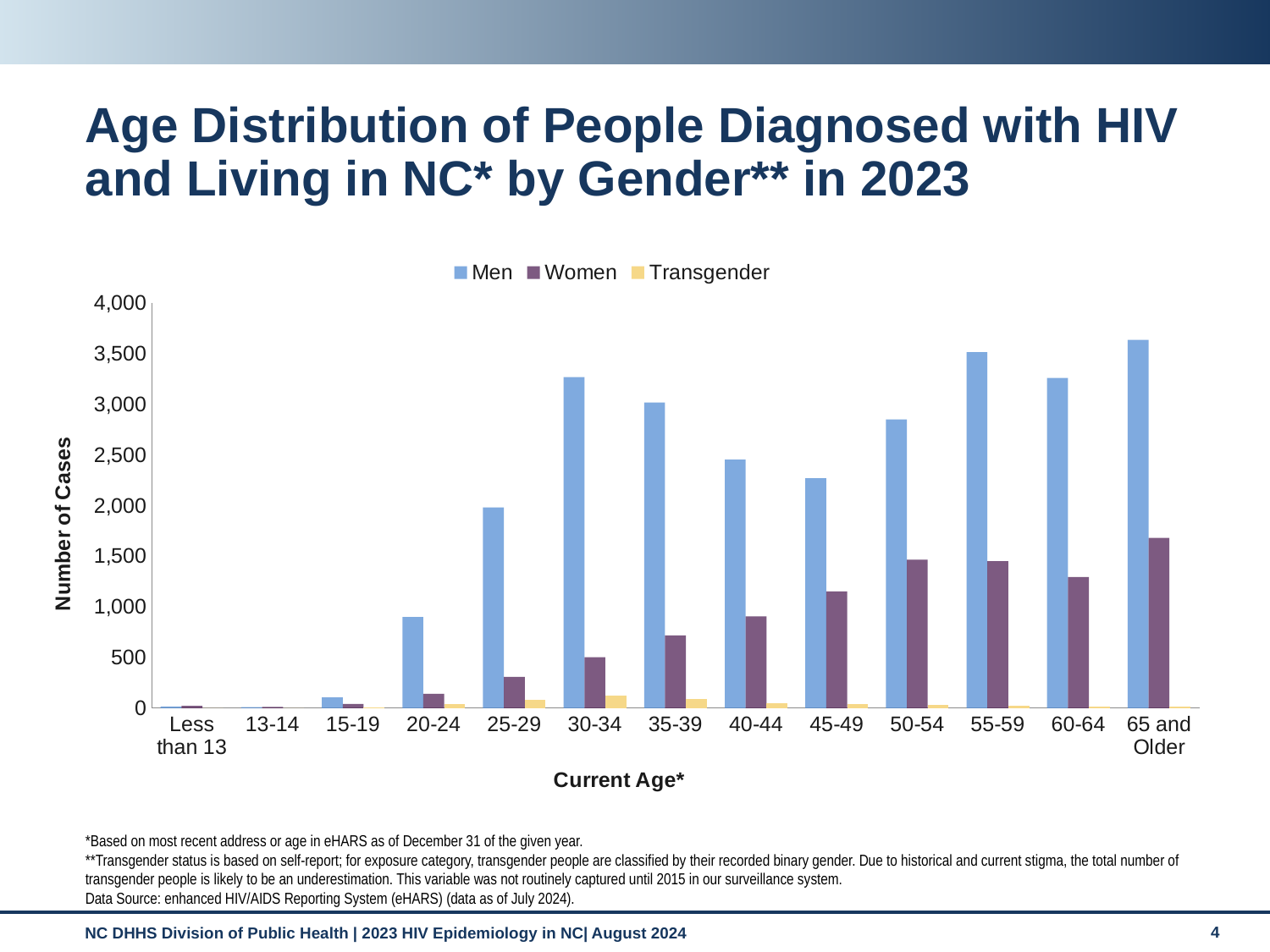
Which age group has the highest number of cases for Men? 65 and Older How many age categories are shown on the x axis? 13 Is the value for Men in the 30-34 age group greater or less than 3,000? greater Which is larger: the number of cases for Men aged 30-34 or Men aged 35-39? Men aged 30-34 Is the value for Men in the 20-24 age group greater or less than 1,000? less Is the value for Men in the 50-54 age group greater or less than 3,000? less What is the label of the y axis? Number of Cases Which is larger: the number of cases for Women aged 55-59 or Women aged 60-64? Women aged 55-59 What kind of chart is shown on the slide? Bar chart How many series does the legend list? 3 Which age group has the highest number of cases for Women? 65 and Older